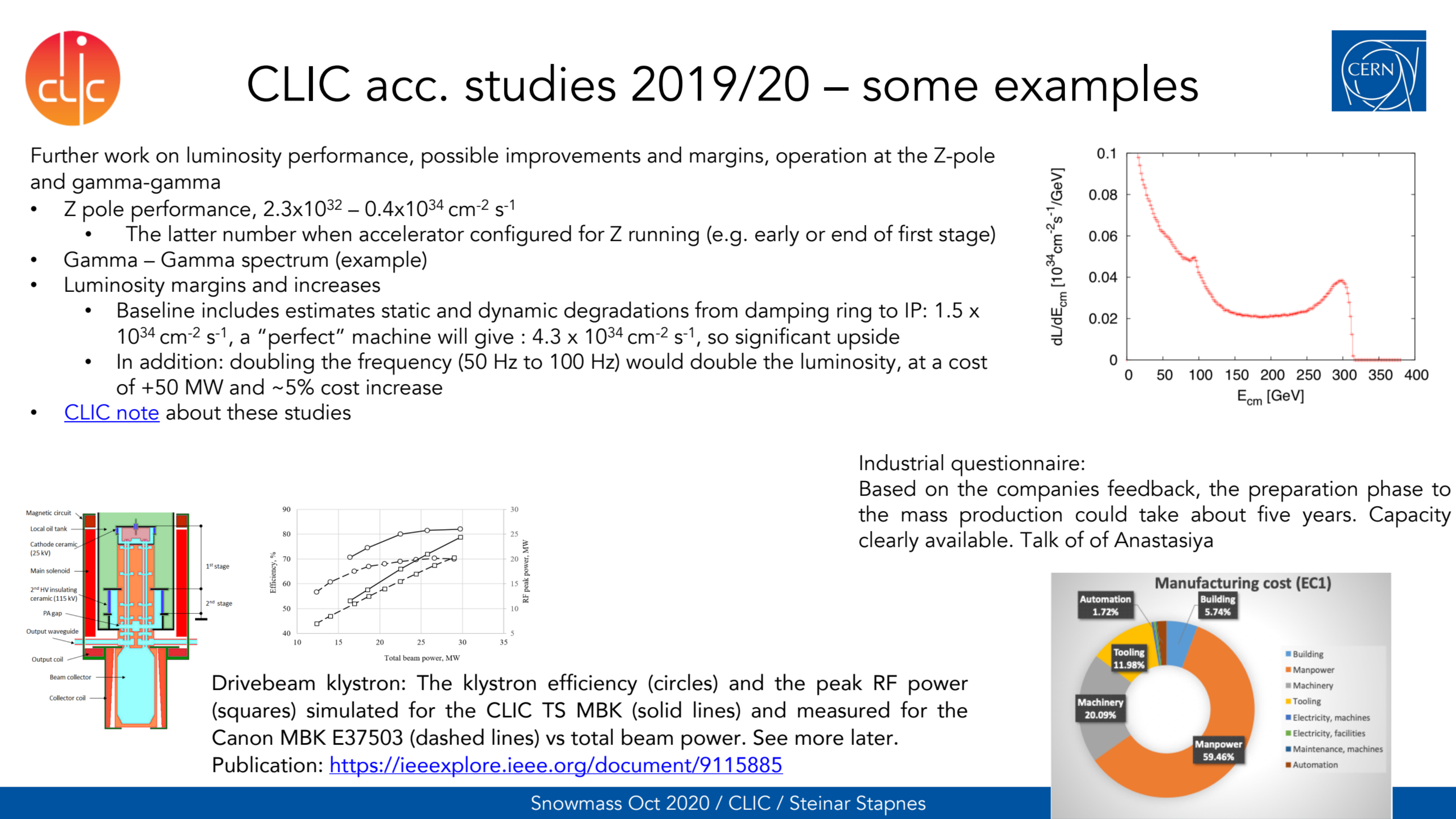
In the Manufacturing cost (EC1) chart, which category has the largest share? Manpower In the Manufacturing cost (EC1) chart, what share does Manpower have? 59.46% In the gamma-gamma spectrum chart at the top right, does the curve rise or fall between E_cm = 0 and 150 GeV? fall In the gamma-gamma spectrum chart at the top right, is the value at E_cm = 350 GeV greater or less than 0.02? less What is the x-axis label of the drivebeam klystron chart at the bottom middle? Total beam power, MW In the Manufacturing cost (EC1) chart, what is the share for Machinery? 20.09% In the Manufacturing cost (EC1) chart, what is the share for Tooling? 11.98% In the Manufacturing cost (EC1) chart, which is larger, Building or Automation? Building In the gamma-gamma spectrum chart at the top right, is the value at E_cm = 50 GeV greater or less than 0.04? greater In the Manufacturing cost (EC1) chart, what is the difference between the Machinery and Tooling shares? 8.11% How many entries does the legend of the Manufacturing cost (EC1) chart list? 8 What kind of chart is the Manufacturing cost (EC1) chart? Pie (donut) chart